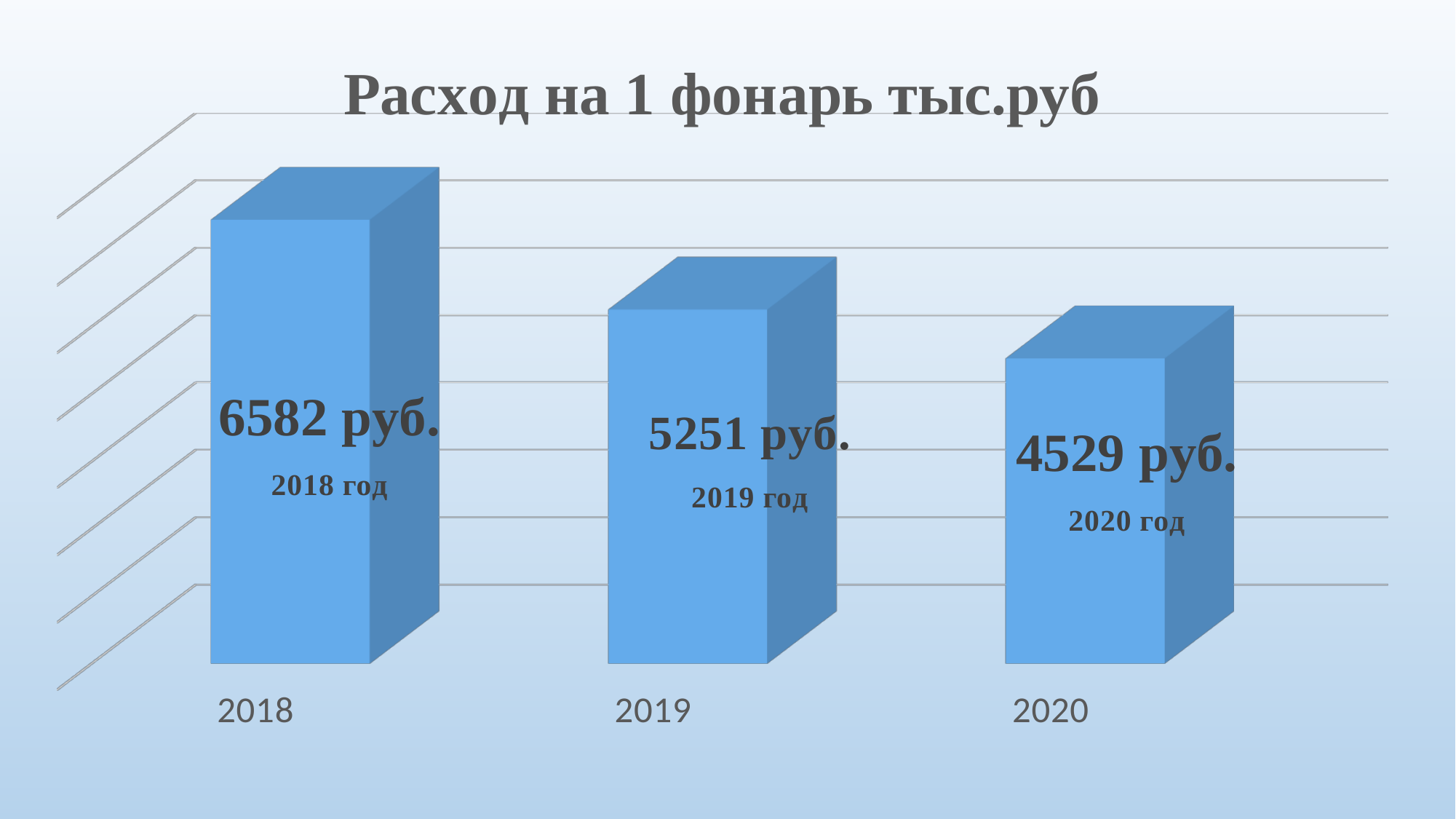
What is the difference between the values for 2018 and 2020? 2053 руб. What is the value for 2019? 5251 руб. Do the values rise or fall from 2018 to 2020? Fall Which is larger, the value for 2019 or the value for 2020? 2019 Which year has the lowest value? 2020 What is the difference between the values for 2019 and 2020? 722 руб. How many years are shown on the chart? 3 What is the value for 2020? 4529 руб. What kind of chart is shown on the slide? Bar chart What is the value for 2018? 6582 руб. Which year has the highest value? 2018 What is the difference between the values for 2018 and 2019? 1331 руб.